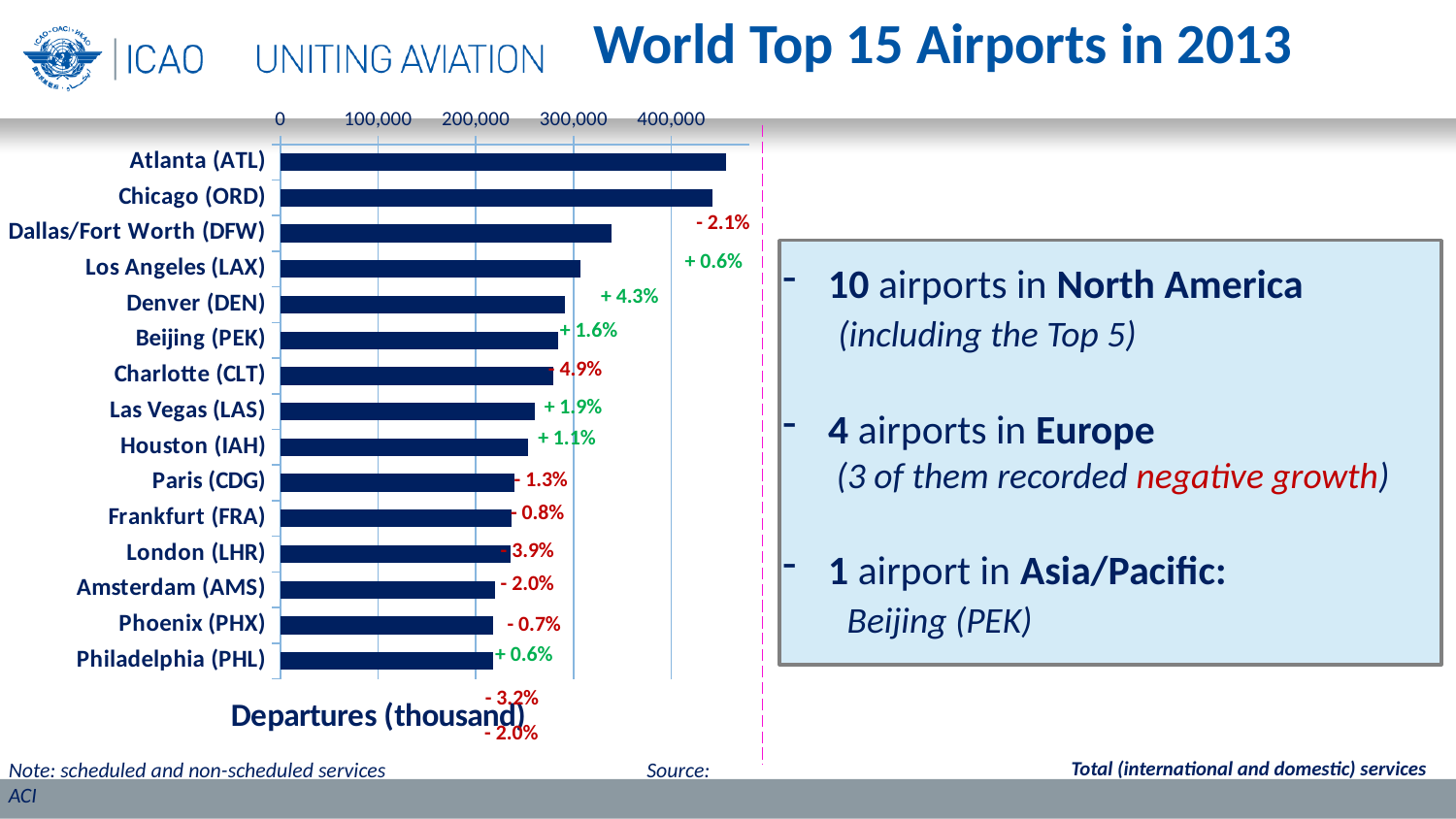
What kind of chart is shown on the slide? bar chart What is the axis title shown below the bars? Departures (thousand) Is the value for Philadelphia (PHL) greater or less than 200,000? greater Is the value for Atlanta (ATL) greater or less than 400,000? greater Is the value for Dallas/Fort Worth (DFW) greater or less than 300,000? greater Which has more departures, Chicago (ORD) or London (LHR)? Chicago (ORD) How many airports are listed in the chart? 15 Do the bar values rise or fall going down the list from Atlanta (ATL) to Philadelphia (PHL)? fall Which has more departures, Atlanta (ATL) or Dallas/Fort Worth (DFW)? Atlanta (ATL) Which airport has the highest number of departures in the chart? Atlanta (ATL)